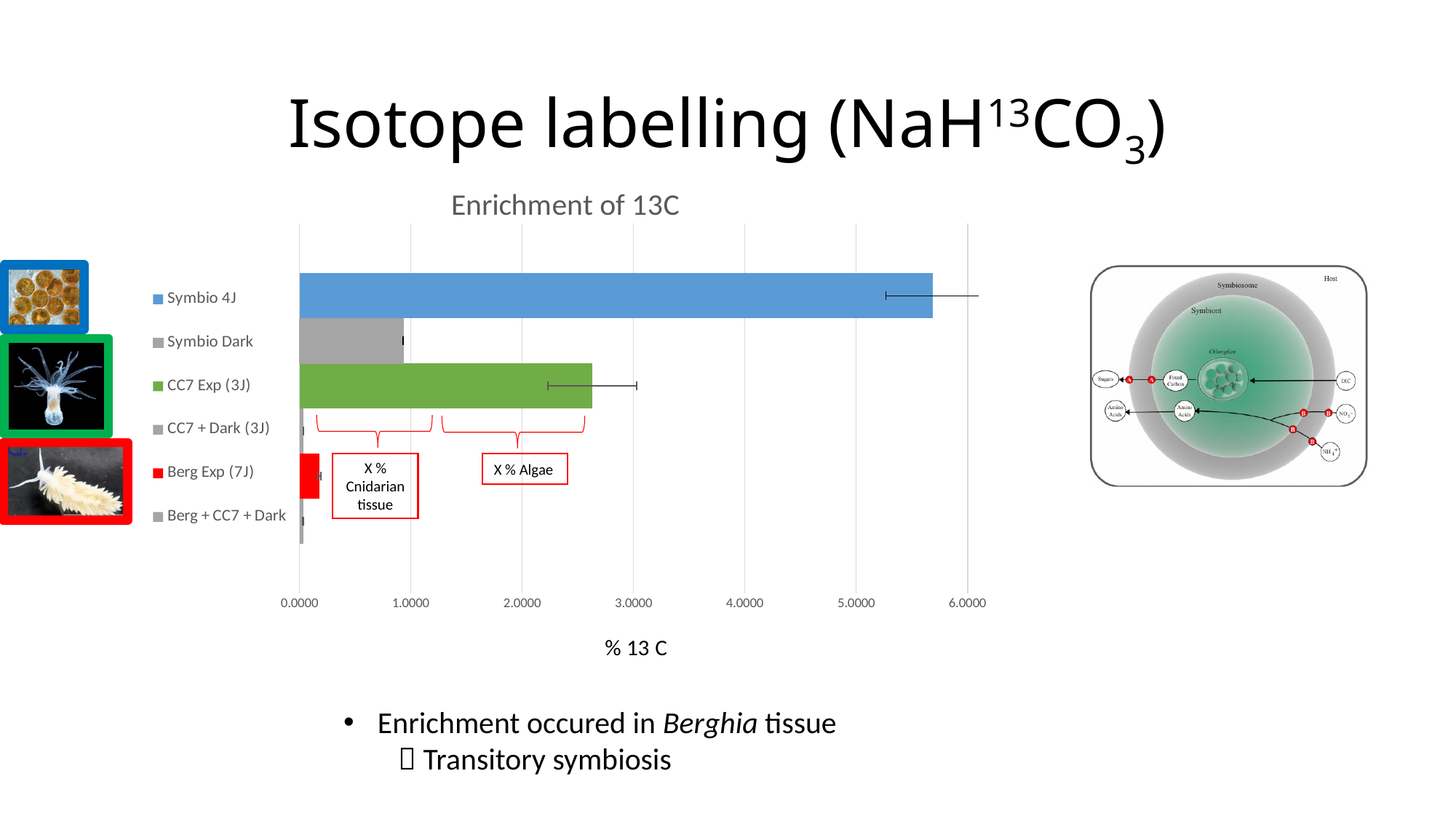
Is the value for Symbio 4J greater or less than 5.0000? greater Is the value for Berg Exp (7J) greater or less than 1.0000? less How many bars are plotted in the chart? 6 Is the value for CC7 Exp (3J) greater or less than 2.0000? greater What kind of chart is shown on the slide? bar chart Which is larger, the value for Berg Exp (7J) or the value for Symbio 4J? Symbio 4J Which is larger, the value for CC7 Exp (3J) or the value for Symbio Dark? CC7 Exp (3J) What is the label on the x axis of the chart? % 13 C Which category has the highest enrichment of 13C? Symbio 4J What is the title of the chart? Enrichment of 13C How many entries does the chart legend list? 6